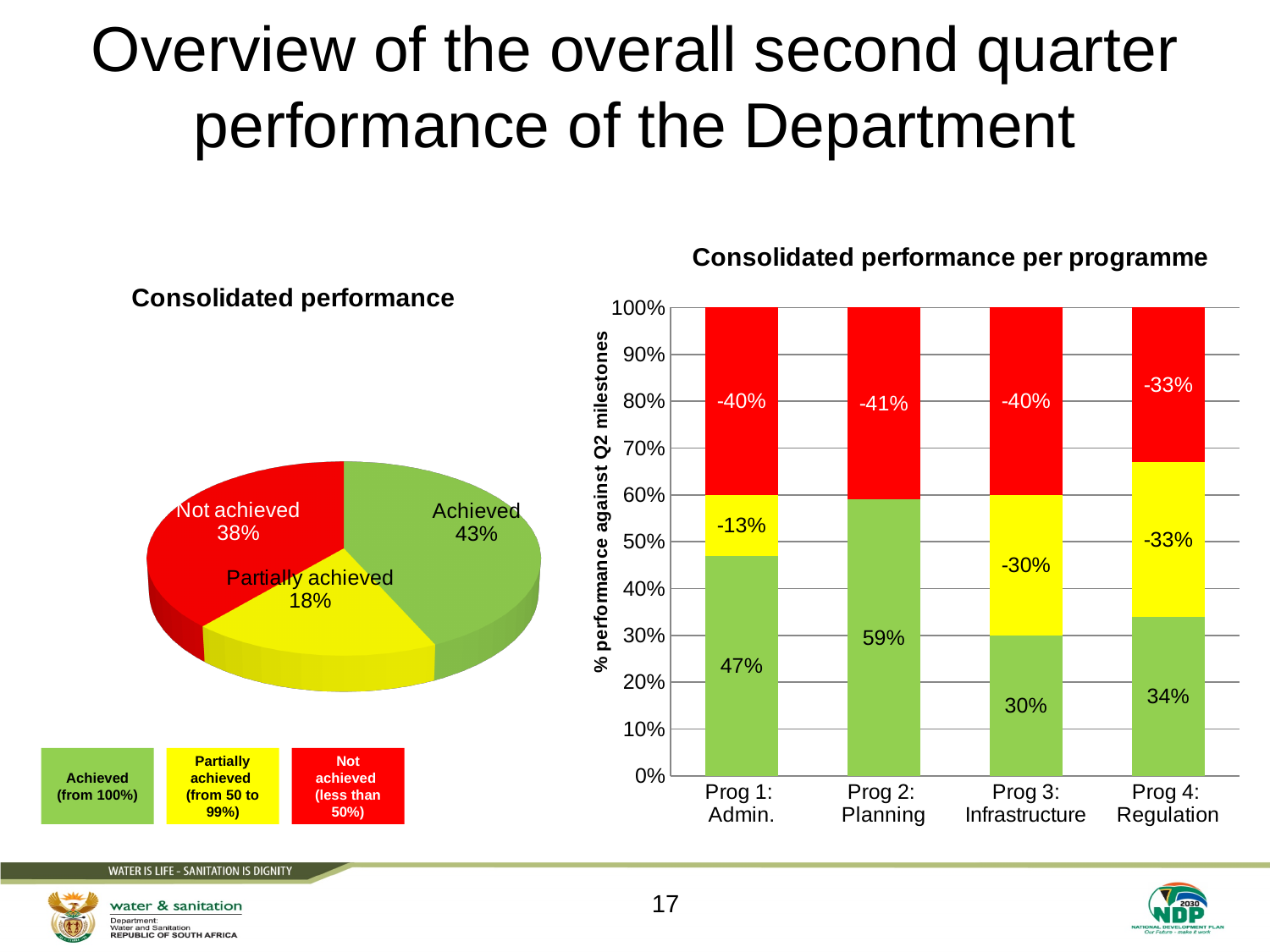
In the 'Consolidated performance per programme' chart, what is the red (not achieved) segment labelled for Prog 1: Admin.? -40% In the 'Consolidated performance per programme' chart, what is the green (achieved) value labelled for Prog 2: Planning? 59% What kind of chart is the 'Consolidated performance' chart on the left? Pie chart In the 'Consolidated performance per programme' chart, what is the difference between the green (achieved) values of Prog 1: Admin. and Prog 3: Infrastructure? 17% In the 'Consolidated performance' pie chart, which slice is the smallest? Partially achieved In the 'Consolidated performance' pie chart, what share is labelled as Not achieved? 38% In the 'Consolidated performance per programme' chart, which programme has the lowest green (achieved) value? Prog 3: Infrastructure What kind of chart is the 'Consolidated performance per programme' chart on the right? Stacked bar chart In the 'Consolidated performance per programme' chart, how many programmes are shown on the x axis? 4 In the 'Consolidated performance' pie chart, what share is labelled as Achieved? 43% In the 'Consolidated performance per programme' chart, which programme has the highest green (achieved) value? Prog 2: Planning In the 'Consolidated performance' pie chart, how many slices are there? 3